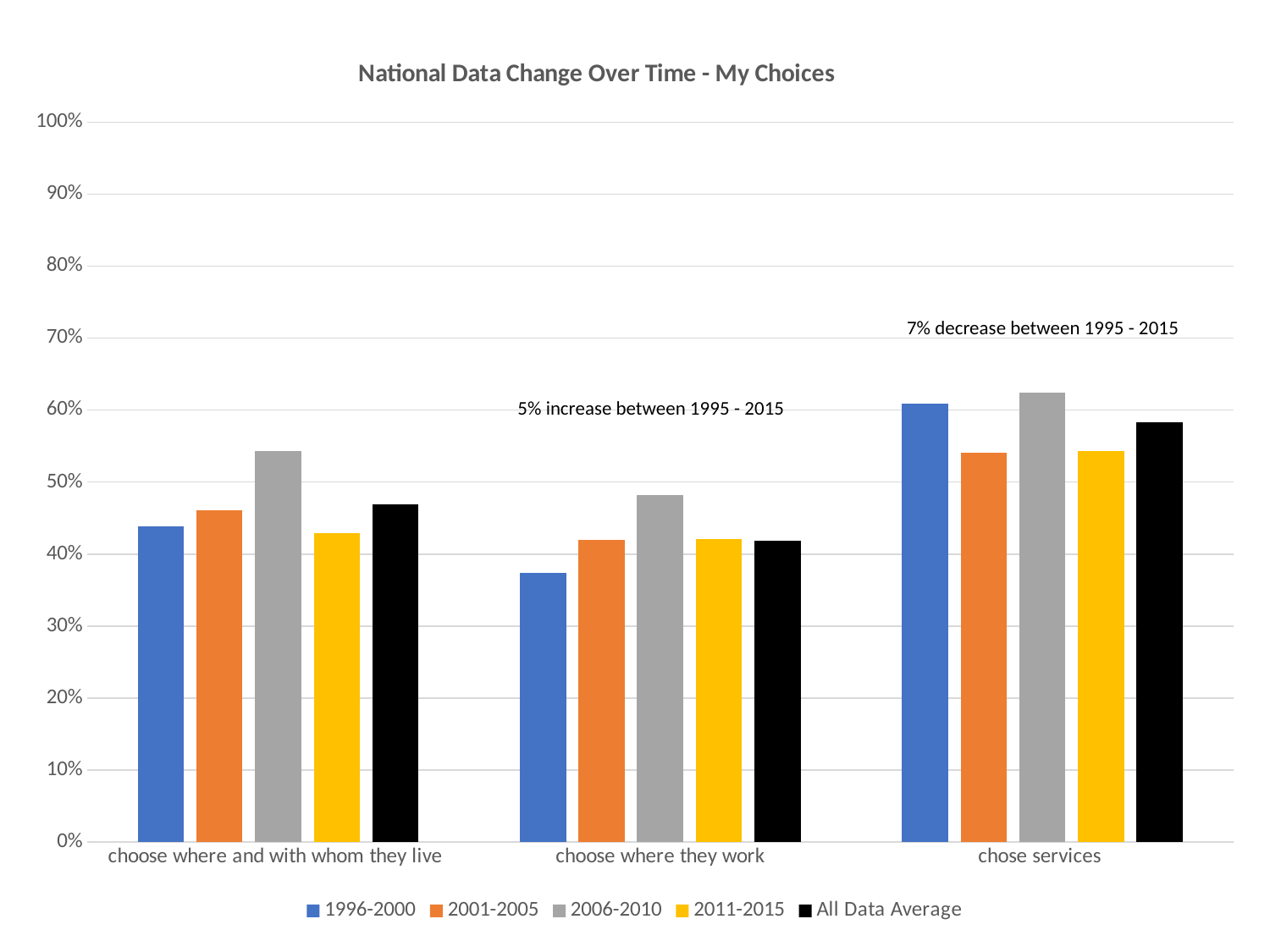
For 'choose where they work', which series has the highest bar? 2006-2010 Is the value for 1996-2000 in 'choose where they work' greater or less than 40%? less Is the value for All Data Average in 'chose services' greater or less than 50%? greater What is the title of the chart? National Data Change Over Time - My Choices Which is larger: the 2006-2010 value for 'chose services' or the 2006-2010 value for 'choose where they work'? chose services What kind of chart is shown on the slide? bar chart How many series does the legend list? 5 Is the value for 2006-2010 in 'choose where and with whom they live' greater or less than 50%? greater For 'choose where and with whom they live', which series has the highest bar? 2006-2010 For 'choose where they work', which series has the lowest bar? 1996-2000 What annotation is written above the 'chose services' bars? 7% decrease between 1995 - 2015 How many categories are shown on the x axis? 3